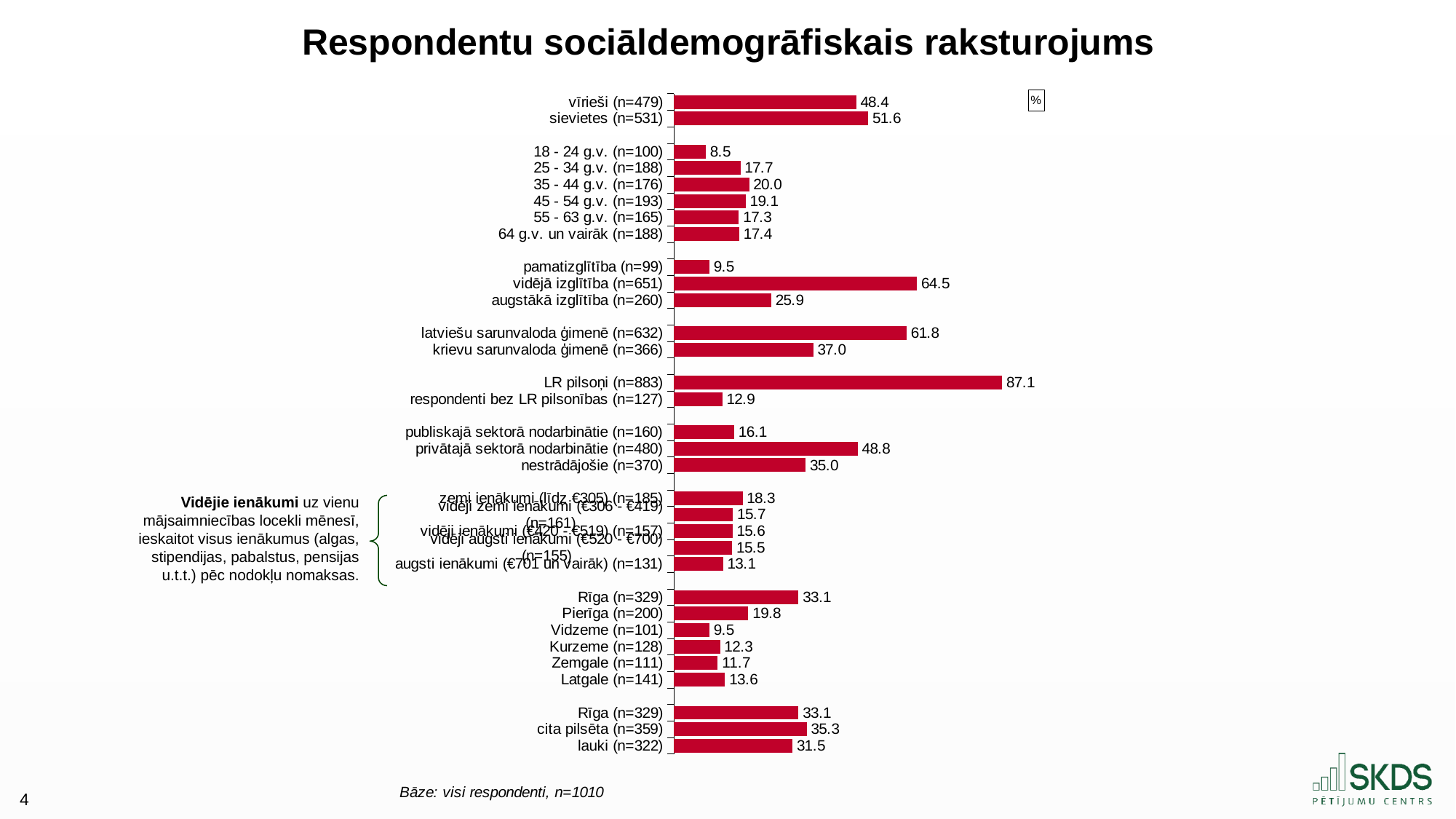
What is the title of the slide? Respondentu sociāldemogrāfiskais raksturojums How many age groups are shown in the chart? 6 What is the difference between the values for latviešu sarunvaloda ģimenē (n=632) and krievu sarunvaloda ģimenē (n=366)? 24.8 What is the value for vidējā izglītība (n=651)? 64.5 What is the value for LR pilsoņi (n=883)? 87.1 What is the value for respondenti bez LR pilsonības (n=127)? 12.9 What is the value for sievietes (n=531)? 51.6 What is the difference between the values for cita pilsēta (n=359) and lauki (n=322)? 3.8 Which is larger: the value for privātajā sektorā nodarbinātie (n=480) or nestrādājošie (n=370)? privātajā sektorā nodarbinātie (n=480) What type of chart is shown on the slide? bar chart Which of the six regions (Rīga, Pierīga, Vidzeme, Kurzeme, Zemgale, Latgale) has the lowest value? Vidzeme (n=101) Which age group has the highest value? 35 - 44 g.v. (n=176)